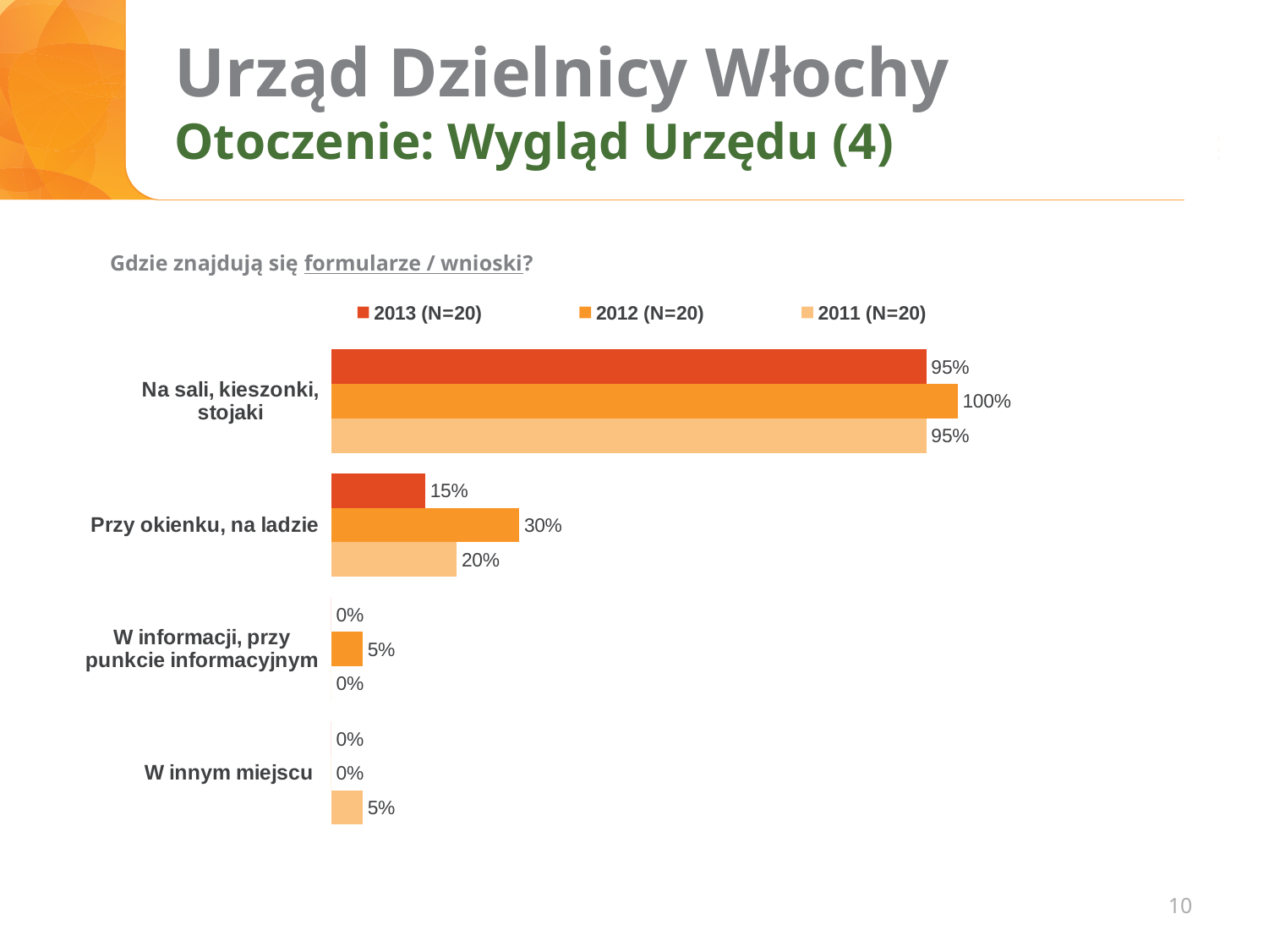
What is the value for "Na sali, kieszonki, stojaki" in the 2012 (N=20) series? 100% What is the difference between the 2012 (N=20) and 2013 (N=20) values for "Przy okienku, na ladzie"? 15% What kind of chart is shown on the slide? Bar chart What question does the chart answer, according to the text above it? Gdzie znajdują się formularze / wnioski? Which category has the highest value in the 2013 (N=20) series? Na sali, kieszonki, stojaki How many categories are shown on the chart? 4 For "Przy okienku, na ladzie", which series has the larger value: 2011 (N=20) or 2012 (N=20)? 2012 (N=20) What is the value for "W innym miejscu" in the 2011 (N=20) series? 5% How many series does the legend list? 3 What is the value for "W informacji, przy punkcie informacyjnym" in the 2012 (N=20) series? 5% What is the value for "Przy okienku, na ladzie" in the 2013 (N=20) series? 15% Which category has the lowest value in the 2012 (N=20) series? W innym miejscu